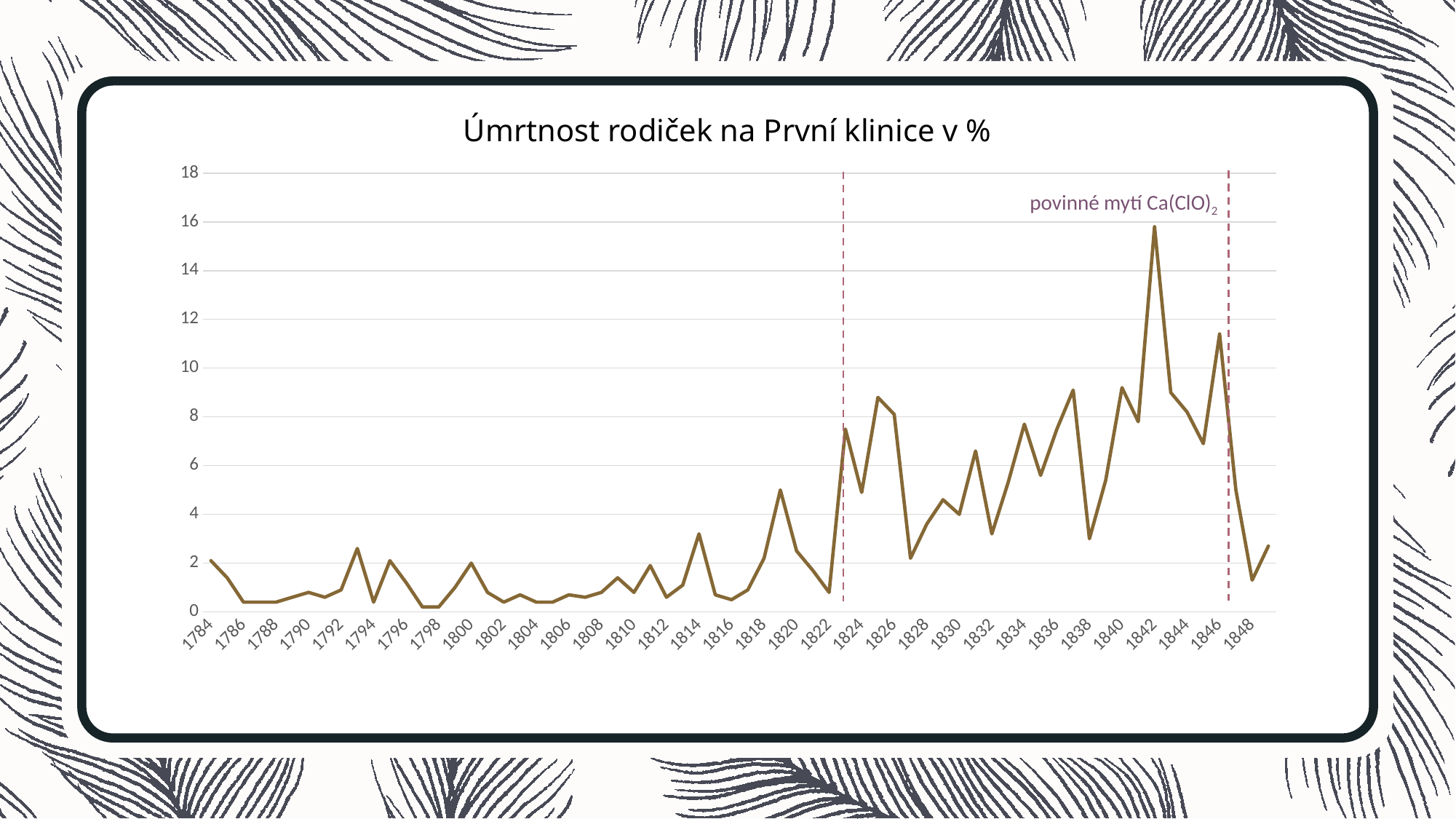
Which year has the larger value, 1842 or 1846? 1842 What text is written next to the right dashed vertical line in the chart? povinné mytí Ca(ClO)2 Is the value for 1826 greater or less than 6? greater Which year has the larger value, 1826 or 1828? 1826 In which year does the line reach its highest value? 1842 Does the line rise or fall between 1846 and 1848? fall What is the title of the chart? Úmrtnost rodiček na První klinice v % Is the value for 1786 greater or less than 2? less Is the value for 1842 greater or less than 14? greater What kind of chart is shown on the slide? line chart